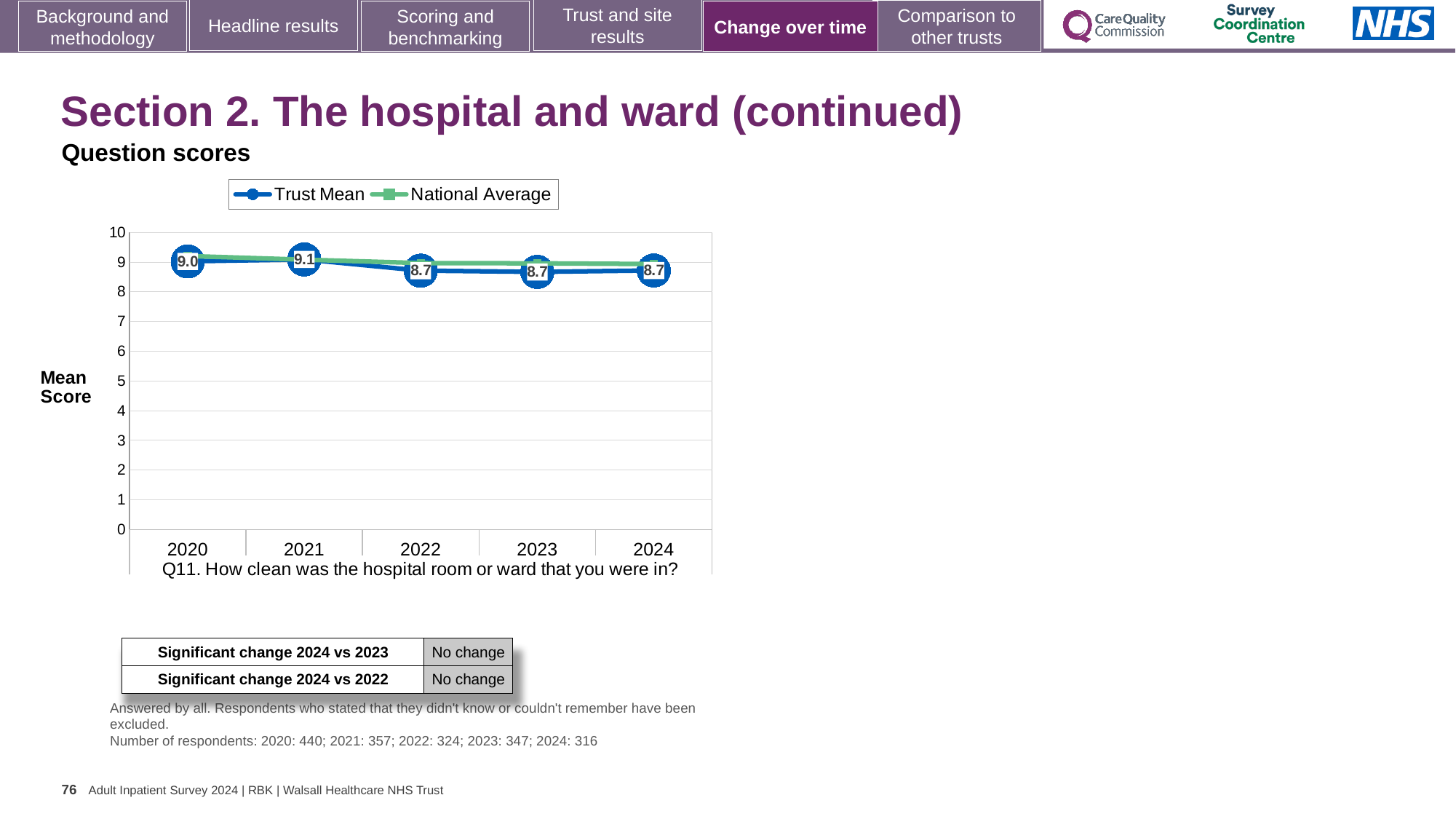
What kind of chart is shown on the slide? Line chart What is the Trust Mean score for 2024? 8.7 How many series does the chart legend list? 2 What is the label on the y axis of the chart? Mean Score What is the difference between the Trust Mean score in 2021 and in 2022? 0.4 Is the National Average value for 2024 greater or less than 8? greater What is the Trust Mean score for 2021? 9.1 In which year is the Trust Mean score highest? 2021 Does the Trust Mean score rise or fall from 2021 to 2022? Fall How many years are shown on the x axis of the chart? 5 What is the Trust Mean score for 2020? 9.0 Is the Trust Mean score for 2020 or for 2021 larger? 2021